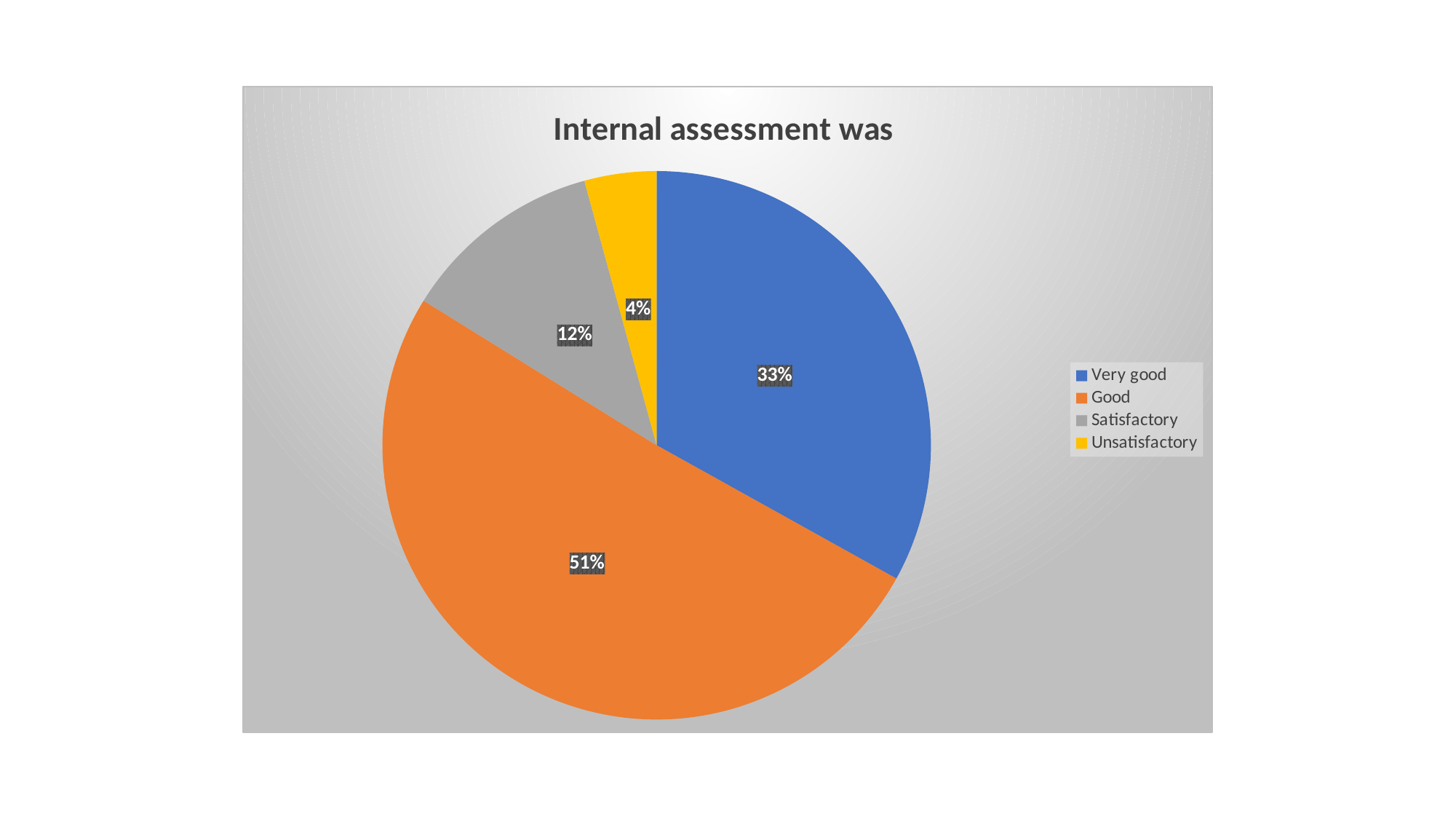
Which category has the largest slice of the pie? Good How many categories does the legend list? 4 What share of the pie is labelled Very good? 33% What kind of chart is shown on the slide? pie chart Which slice is larger, Satisfactory or Unsatisfactory? Satisfactory Which category has the smallest slice of the pie? Unsatisfactory What share of the pie is labelled Unsatisfactory? 4% What colour is the slice for Satisfactory? grey What is the title of the chart? Internal assessment was What is the difference in percentage points between the Good and Very good slices? 18 What share of the pie is labelled Good? 51%